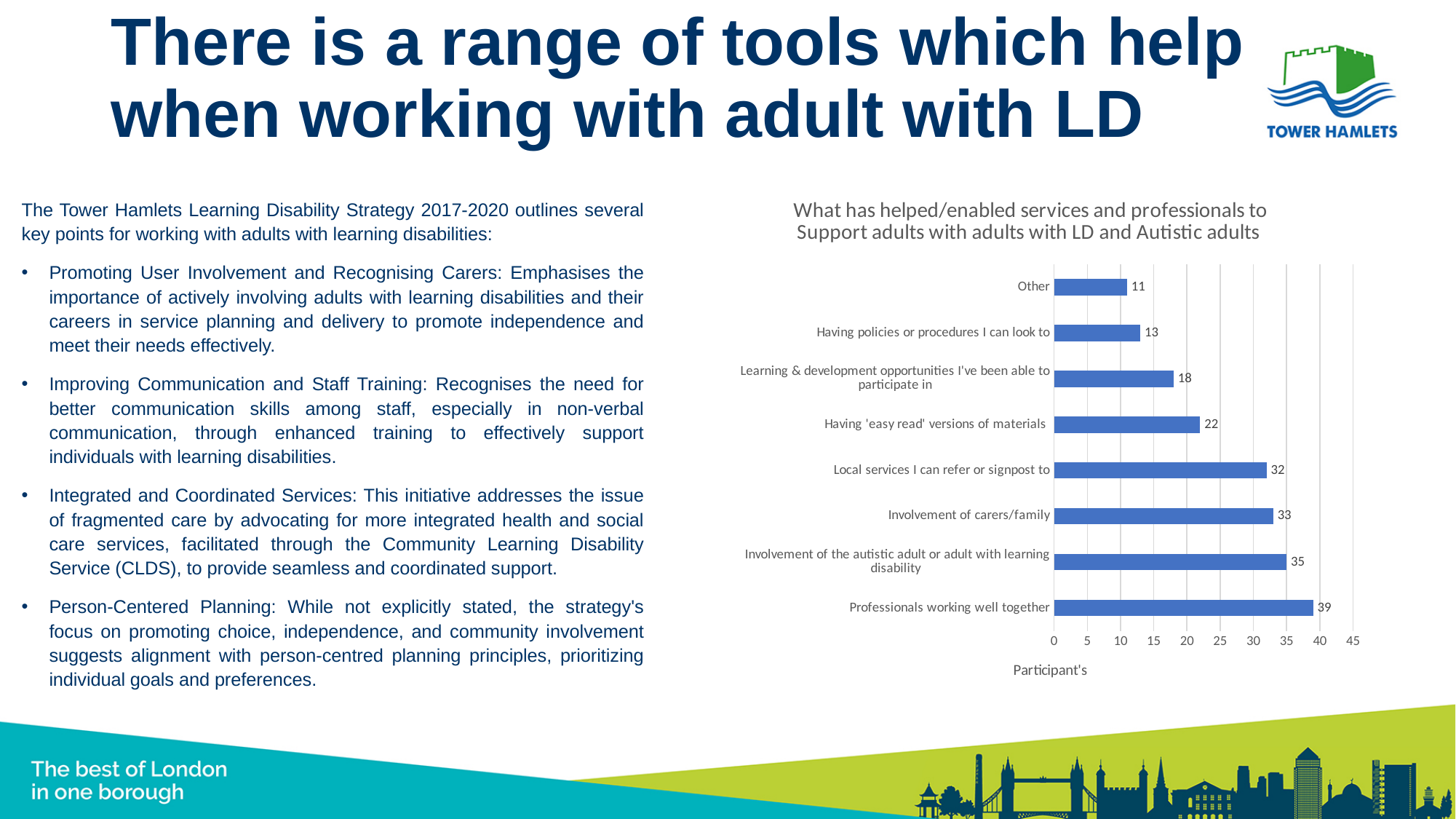
Is the value for 'Learning & development opportunities I've been able to participate in' greater or less than 20? less What kind of chart is shown on the slide? Bar chart What is the difference between 'Involvement of the autistic adult or adult with learning disability' and 'Involvement of carers/family'? 2 What is the value for 'Other'? 11 What is the value for 'Having 'easy read' versions of materials'? 22 How many categories are shown in the chart? 8 Which category has the highest value? Professionals working well together What is the label on the horizontal axis of the chart? Participant's Which category has the lowest value? Other Which is larger: 'Local services I can refer or signpost to' or 'Having policies or procedures I can look to'? Local services I can refer or signpost to What is the value for 'Professionals working well together'? 39 What is the difference between 'Professionals working well together' and 'Other'? 28